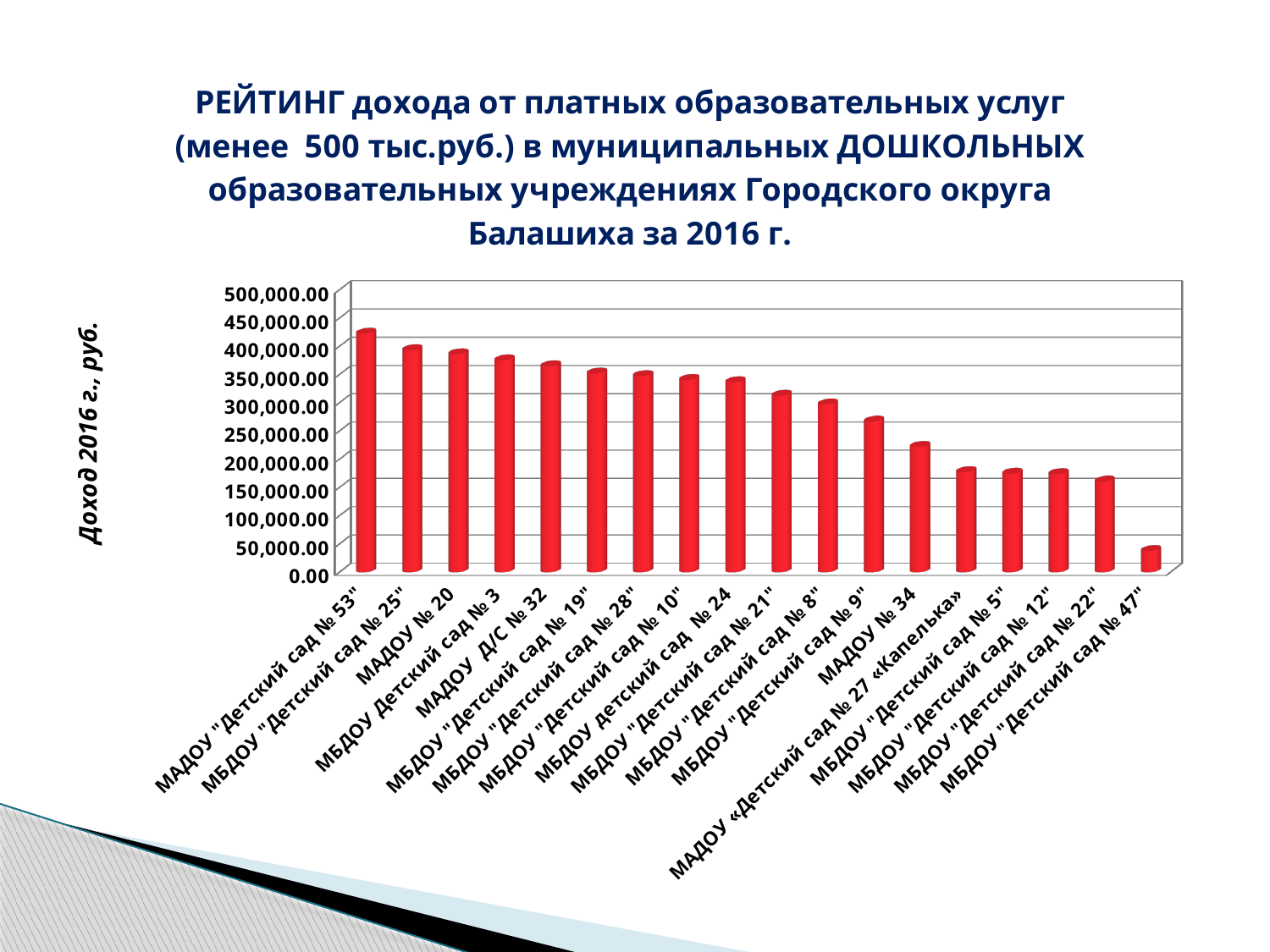
Is the value for МБДОУ "Детский сад № 9" greater or less than 300,000.00? less What kind of chart is shown on the slide? bar chart Which institution has the lowest income in the chart? МБДОУ "Детский сад № 47" Is the value for МАДОУ № 34 greater or less than 200,000.00? greater What is the title of the vertical axis? Доход 2016 г., руб. Which has a larger value: МБДОУ "Детский сад № 21" or МАДОУ № 34? МБДОУ "Детский сад № 21" What colour are the bars in the chart? red Is the value for МАДОУ "Детский сад № 53" greater or less than 400,000.00? greater Which institution has the highest income in the chart? МАДОУ "Детский сад № 53" Do the values rise or fall from left to right along the x axis? fall How many institutions (bars) are shown in the chart? 18